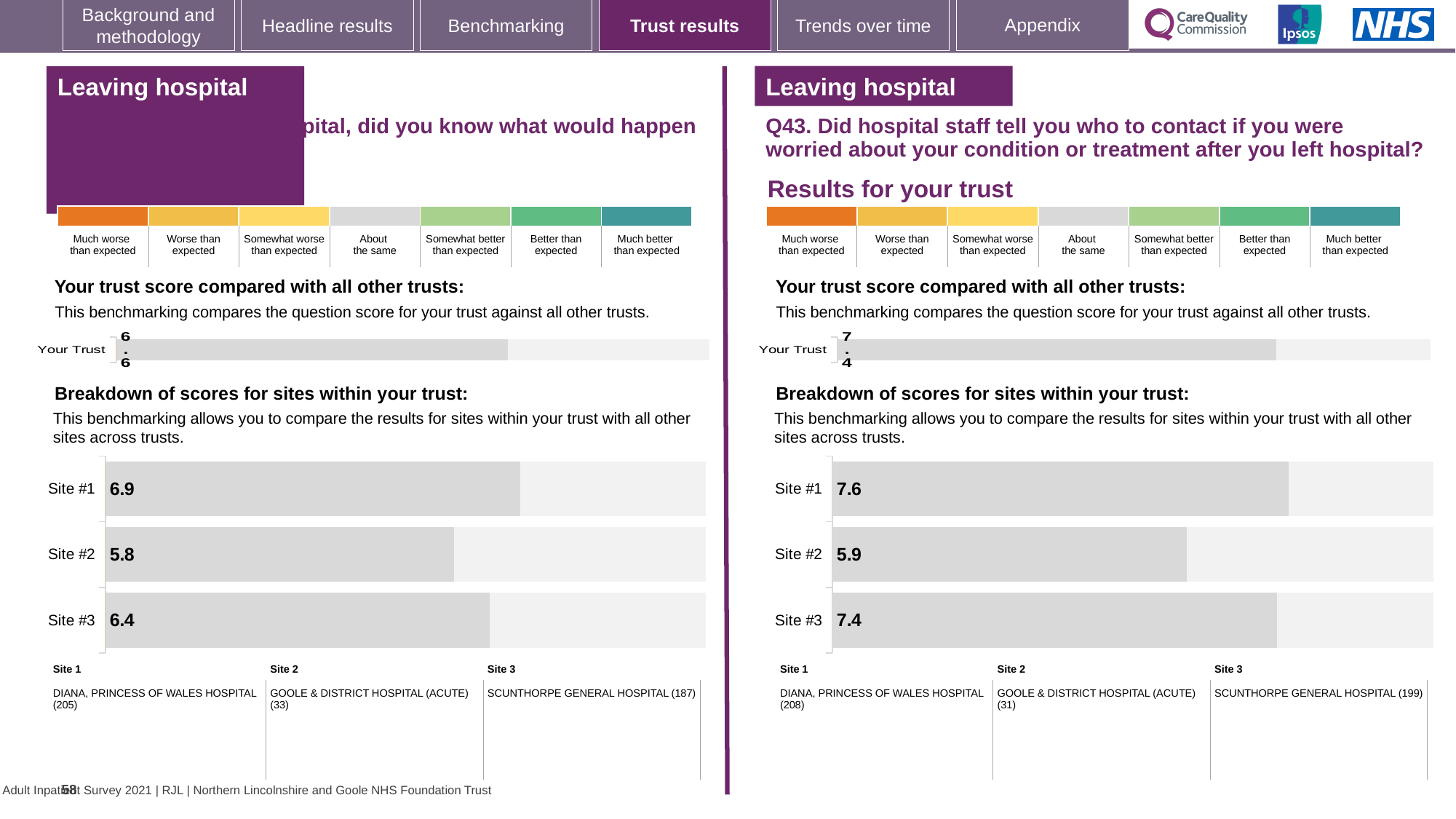
On the right-hand (Q43) 'Breakdown of scores for sites within your trust' chart, which site has the highest score? Site #1 On the right-hand (Q43) 'Breakdown of scores for sites within your trust' chart, what is the difference between the scores for Site #1 and Site #2? 1.7 On the left-hand 'Breakdown of scores for sites within your trust' chart, what is the score for Site #2? 5.8 On the left-hand 'Breakdown of scores for sites within your trust' chart, which site has the lowest score? Site #2 How many sites are shown on the right-hand (Q43) 'Breakdown of scores for sites within your trust' chart? 3 On the left-hand 'Your trust score compared with all other trusts' chart, what is the score for Your Trust? 6.6 What kind of chart is the left-hand 'Breakdown of scores for sites within your trust' chart? Bar chart On the right-hand (Q43) 'Breakdown of scores for sites within your trust' chart, what is the score for Site #1? 7.6 On the left-hand 'Breakdown of scores for sites within your trust' chart, what is the score for Site #1? 6.9 On the right-hand (Q43) 'Your trust score compared with all other trusts' chart, what is the score for Your Trust? 7.4 On the left-hand 'Breakdown of scores for sites within your trust' chart, what is the difference between the scores for Site #1 and Site #3? 0.5 On the right-hand (Q43) 'Breakdown of scores for sites within your trust' chart, what is the score for Site #3? 7.4